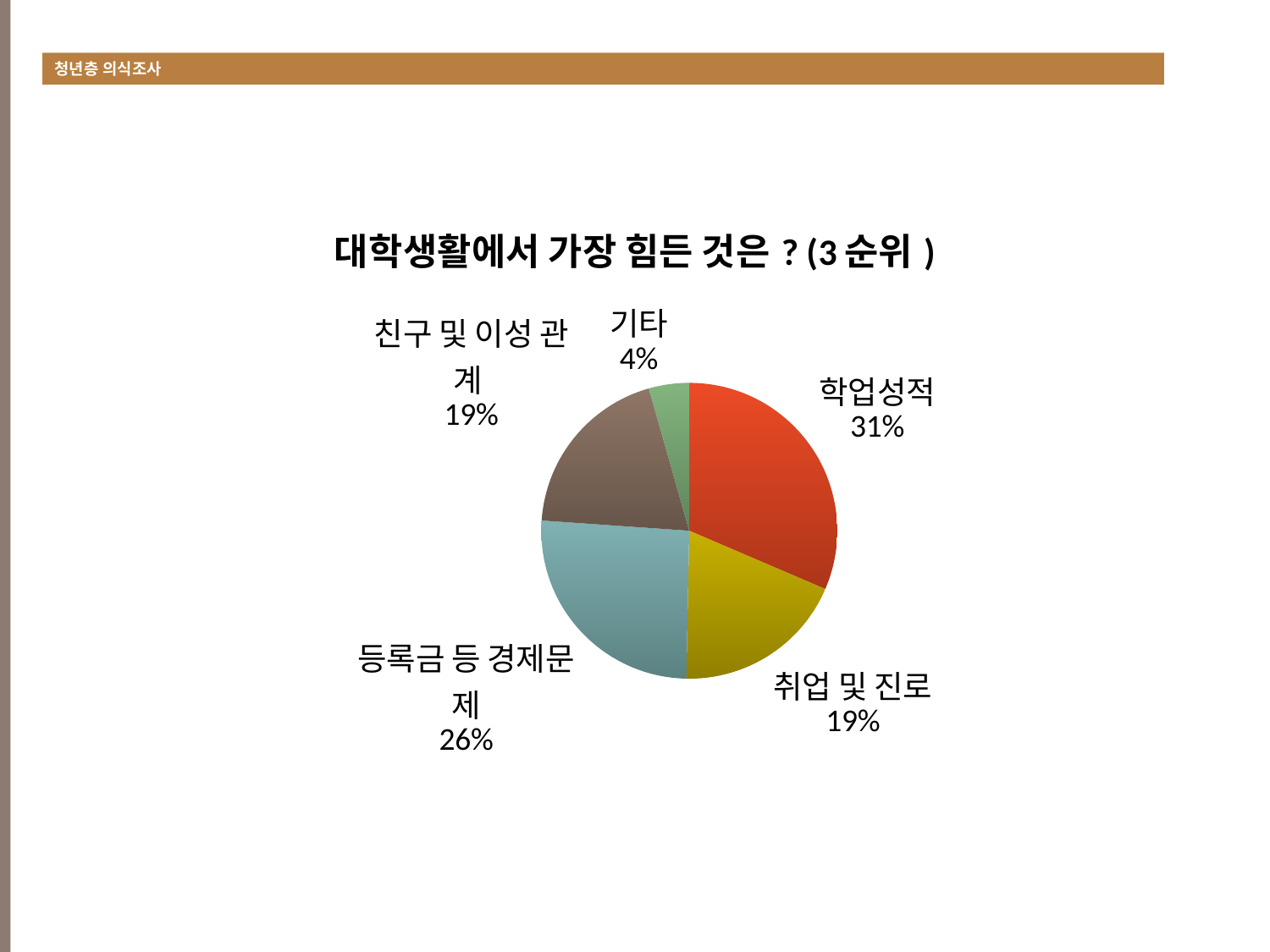
What is the value shown for 기타? 4% What is the title of the chart? 대학생활에서 가장 힘든 것은 ? (3 순위 ) Which category has the smallest slice of the pie? 기타 What share of the pie does 학업성적 represent? 31% What is the difference between the shares for 학업성적 and 등록금 등 경제문제? 5% What is the value shown for 등록금 등 경제문제? 26% What kind of chart is shown on the slide? pie chart What colour is the slice for 학업성적? red What is the value shown for 취업 및 진로? 19% Which is larger, the share for 등록금 등 경제문제 or the share for 친구 및 이성 관계? 등록금 등 경제문제 How many categories are shown in the pie chart? 5 Which category has the largest slice of the pie? 학업성적